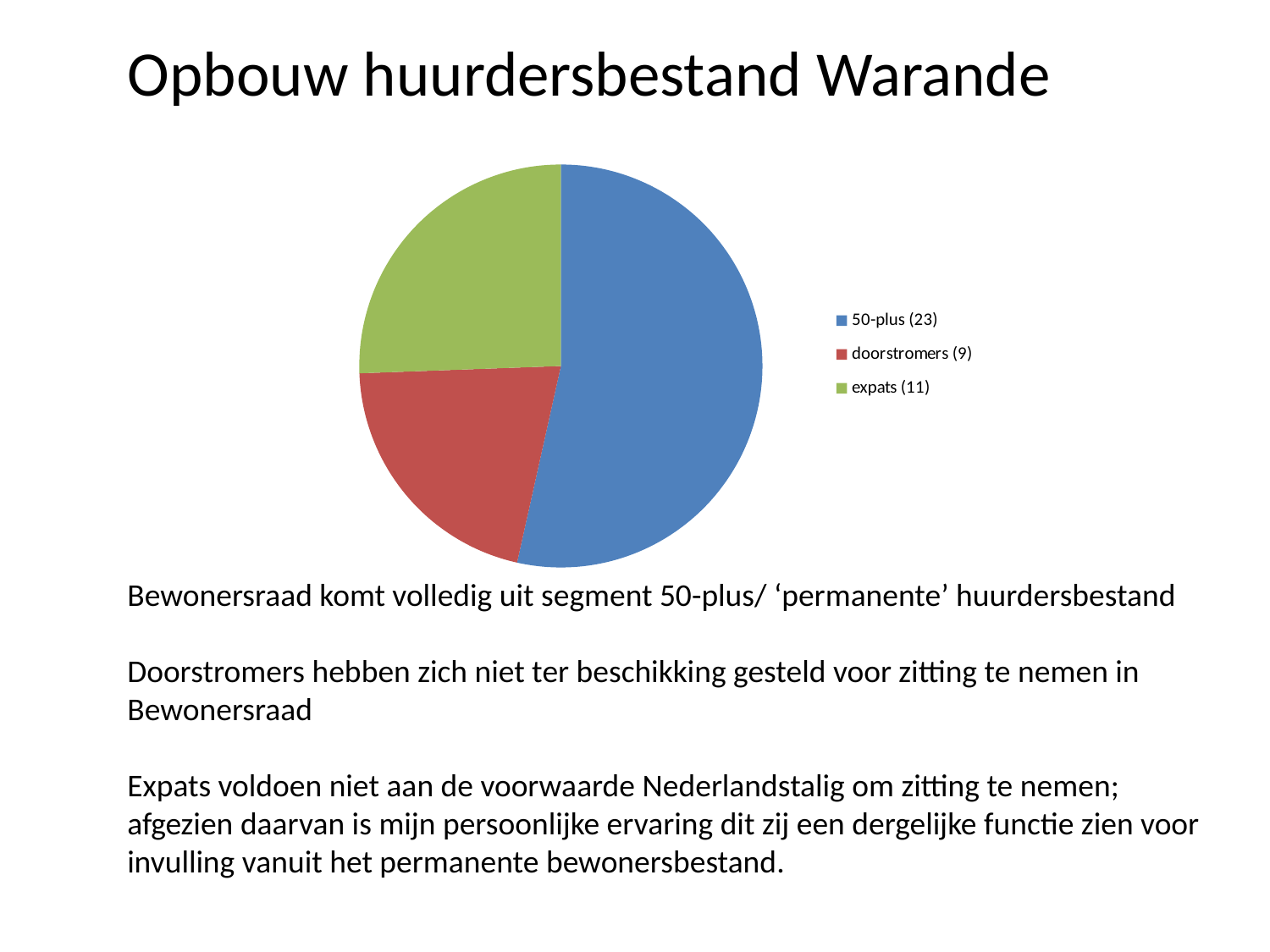
How many slices does the pie chart have? 3 Which is larger, the value for expats or the value for doorstromers? expats Which category has the largest slice of the pie chart? 50-plus What is the value for expats in the pie chart? 11 Which category has the smallest slice of the pie chart? doorstromers Which colour represents expats in the pie chart? green What is the difference between the values for 50-plus and expats? 12 What is the value for 50-plus in the pie chart? 23 What kind of chart is shown on the slide? pie chart What is the value for doorstromers in the pie chart? 9 What is the difference between the values for expats and doorstromers? 2 What is the total of all three categories in the pie chart? 43